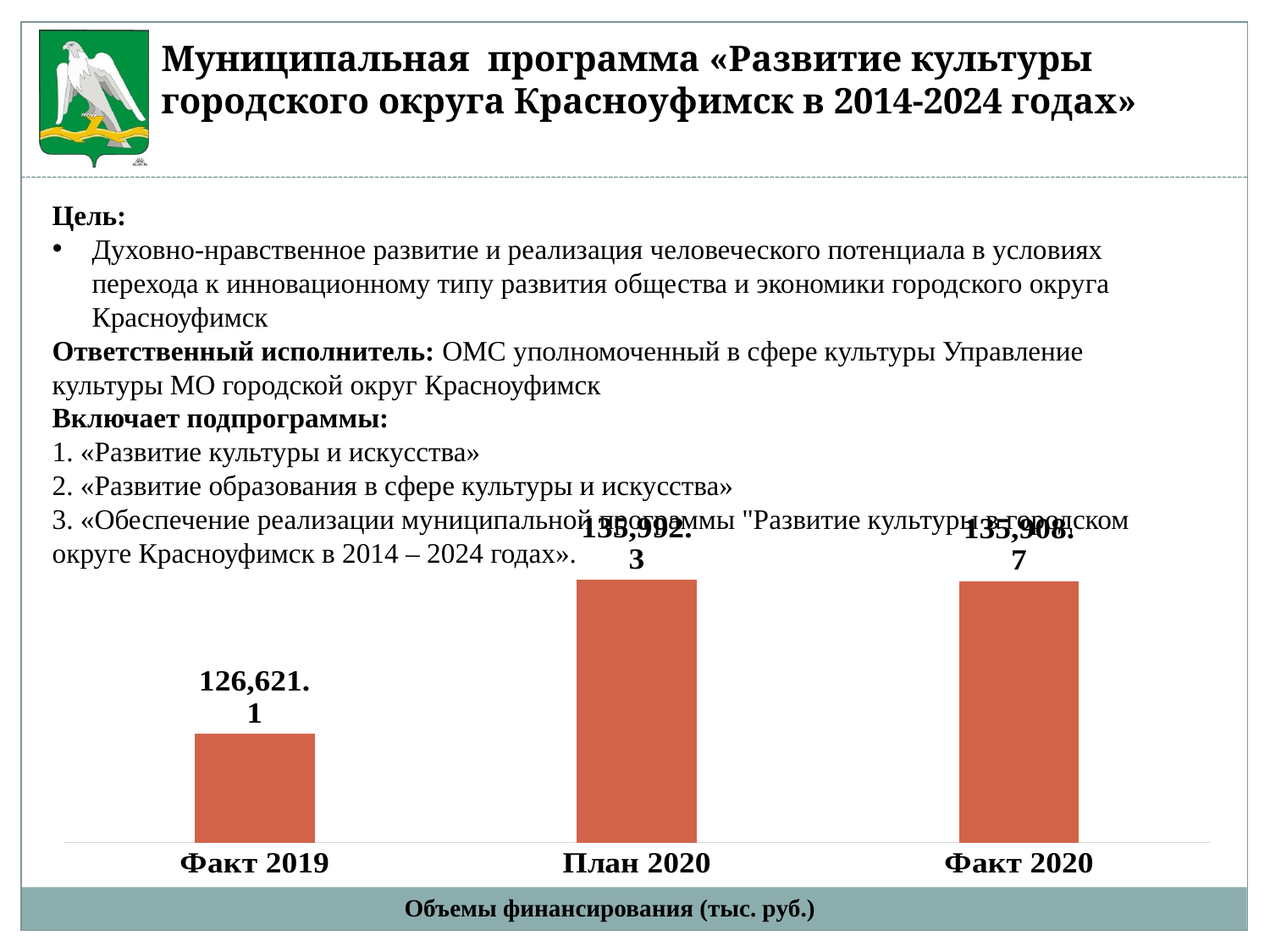
What is the value for План 2020? 135,992.3 What is the difference between the values for План 2020 and Факт 2019? 9,371.2 Which category has the lowest value? Факт 2019 Does the value rise or fall from Факт 2019 to План 2020? Rise How many bars are shown in the chart? 3 What is the title shown beneath the chart? Объемы финансирования (тыс. руб.) What kind of chart is shown on the slide? Bar chart What is the value for Факт 2020? 135,908.7 Which is larger, the value for Факт 2019 or the value for План 2020? План 2020 What is the label of the first bar on the left? Факт 2019 Which is larger, the value for Факт 2020 or the value for Факт 2019? Факт 2020 What is the value for Факт 2019? 126,621.1